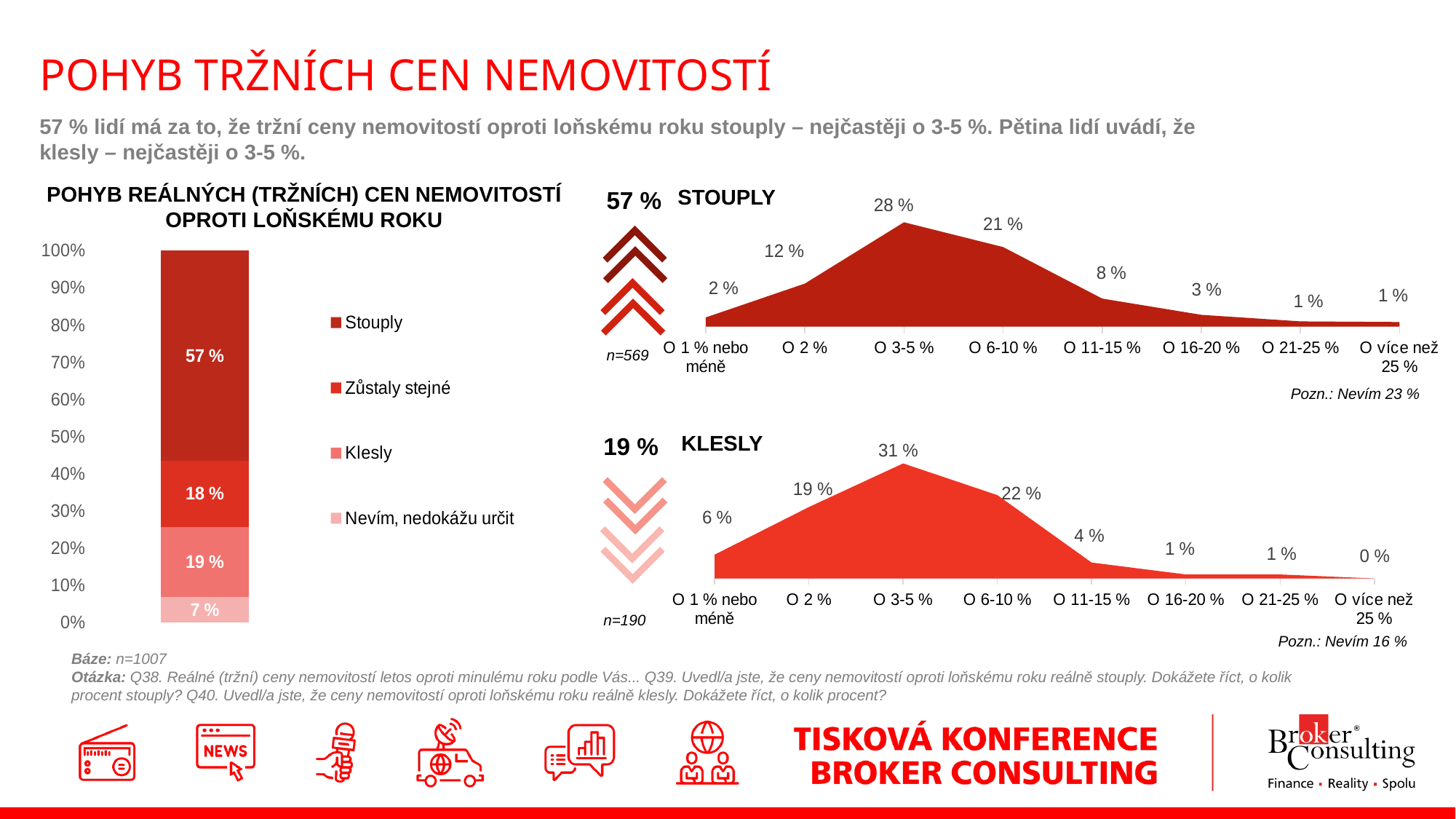
In the STOUPLY chart, which category has the highest value? O 3-5 % In the KLESLY chart, what is the value for "O 6-10 %"? 22 % In the stacked bar chart on the left, what is the value for "Stouply"? 57 % In the stacked bar chart on the left, which of "Zůstaly stejné" and "Klesly" has the larger value? Klesly In the stacked bar chart on the left, how many series does the legend list? 4 In the stacked bar chart on the left, what is the value for "Nevím, nedokážu určit"? 7 % In the KLESLY chart, what is the difference between the values for "O 3-5 %" and "O 2 %"? 12 % In the stacked bar chart on the left, what is the difference between the "Stouply" and "Klesly" values? 38 % What type of chart is the STOUPLY chart? Area chart In the STOUPLY chart, how many categories are shown on the x axis? 8 In the STOUPLY chart, what is the value for "O 3-5 %"? 28 % In the KLESLY chart, which category has the lowest value? O více než 25 %